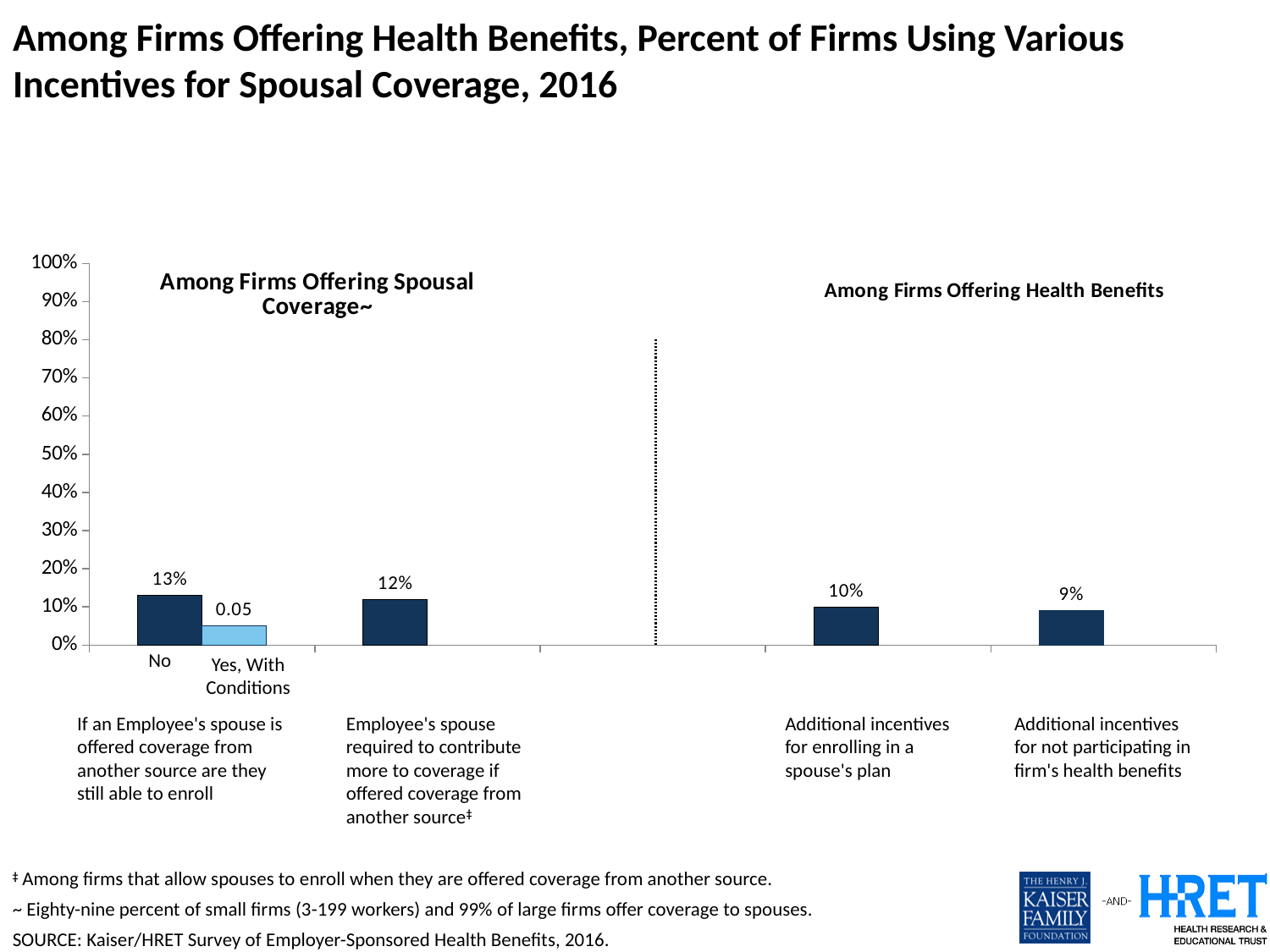
Which is larger: the "No" bar or the bar for employee's spouse required to contribute more to coverage? No What value is shown for the "Yes, With Conditions" bar? 0.05 Which bar has the highest value on the chart? No What percent of firms answered "No" to whether an employee's spouse offered coverage from another source is still able to enroll? 13% What percent of firms require an employee's spouse to contribute more to coverage if offered coverage from another source? 12% What percent of firms offer additional incentives for enrolling in a spouse's plan? 10% Is the value for additional incentives for enrolling in a spouse's plan greater or less than 20%? less Which bar has the lowest value on the chart? Yes, With Conditions What percent of firms offer additional incentives for not participating in the firm's health benefits? 9% How many bars are plotted on the chart? 5 What is the difference between the percent of firms offering additional incentives for enrolling in a spouse's plan and the percent offering additional incentives for not participating in the firm's health benefits? 1% What type of chart is shown on the slide? Bar chart